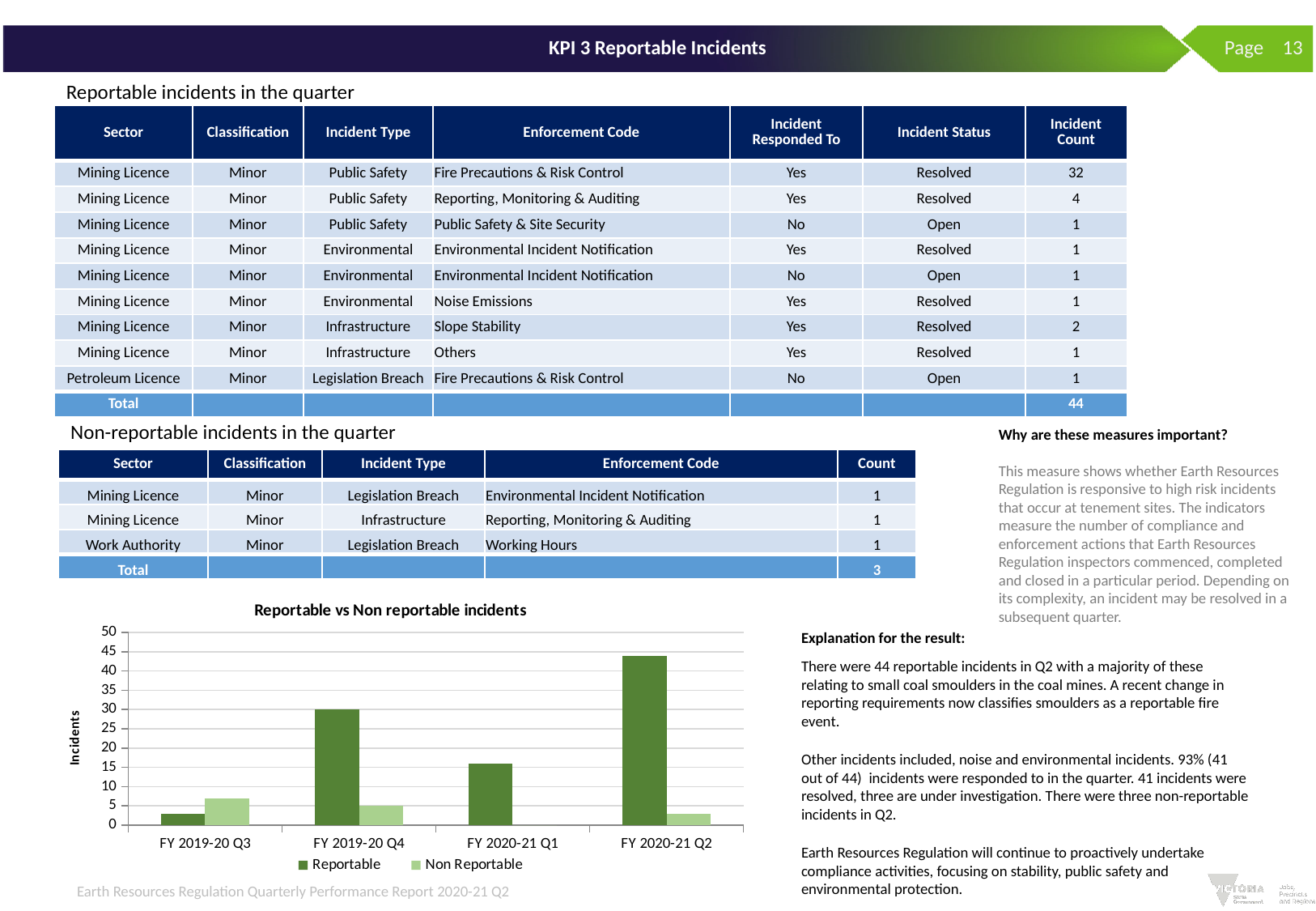
What is the y-axis label of the 'Reportable vs Non reportable incidents' chart? Incidents In the 'Reportable vs Non reportable incidents' chart, which quarter has the highest Reportable value? FY 2020-21 Q2 In the 'Reportable vs Non reportable incidents' chart, which is larger for FY 2019-20 Q3: Reportable or Non Reportable? Non Reportable In the 'Reportable vs Non reportable incidents' chart, is the Non Reportable value for FY 2019-20 Q3 greater or less than 5? greater In the 'Reportable vs Non reportable incidents' chart, which is larger: Reportable for FY 2019-20 Q4 or Reportable for FY 2020-21 Q1? FY 2019-20 Q4 How many series does the legend of the 'Reportable vs Non reportable incidents' chart list? 2 In the 'Reportable vs Non reportable incidents' chart, is the Reportable value for FY 2020-21 Q1 greater or less than 20? less In the 'Reportable vs Non reportable incidents' chart, which quarter has the lowest Reportable value? FY 2019-20 Q3 How many quarters are shown on the x axis of the 'Reportable vs Non reportable incidents' chart? 4 In the 'Reportable vs Non reportable incidents' chart, which quarter has the highest Non Reportable value? FY 2019-20 Q3 In the 'Reportable vs Non reportable incidents' chart, is the Reportable value for FY 2020-21 Q2 greater or less than 40? greater What kind of chart is 'Reportable vs Non reportable incidents'? bar chart